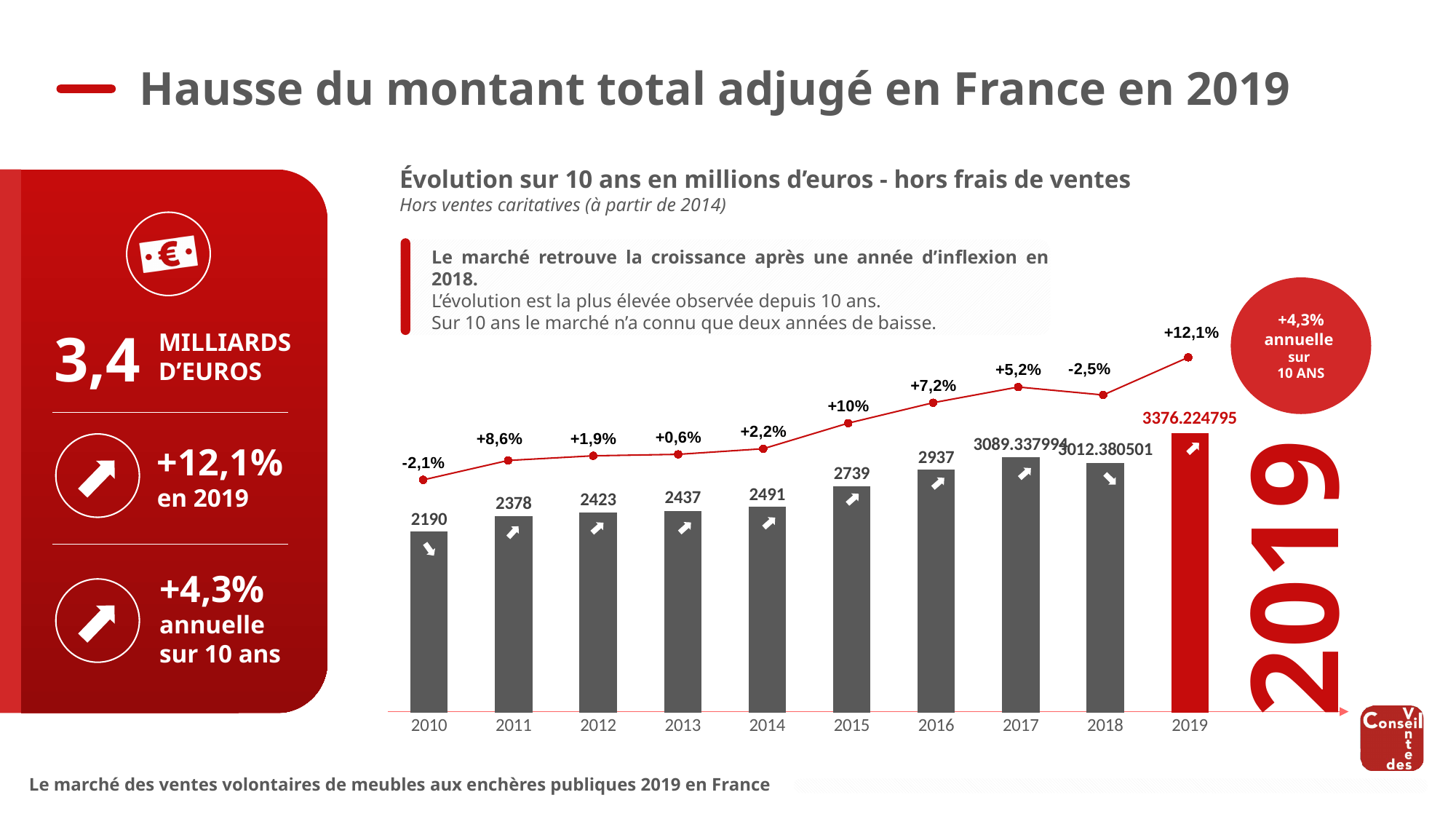
What is the difference between the bar values for 2016 and 2015? 198 Which is larger, the bar value for 2017 or for 2018? 2017 How many years are shown on the x axis? 10 What is the value of the bar for 2015? 2739 What colour is the bar for 2019? red Which year has the lowest bar value? 2010 What percentage change is shown on the line for 2011? +8,6% What percentage change is shown on the line for 2018? -2,5% What is the value of the bar for 2019? 3376.224795 Do the bar values generally rise or fall from 2010 to 2019? rise Which year has the highest bar value? 2019 What is the value of the bar for 2010? 2190